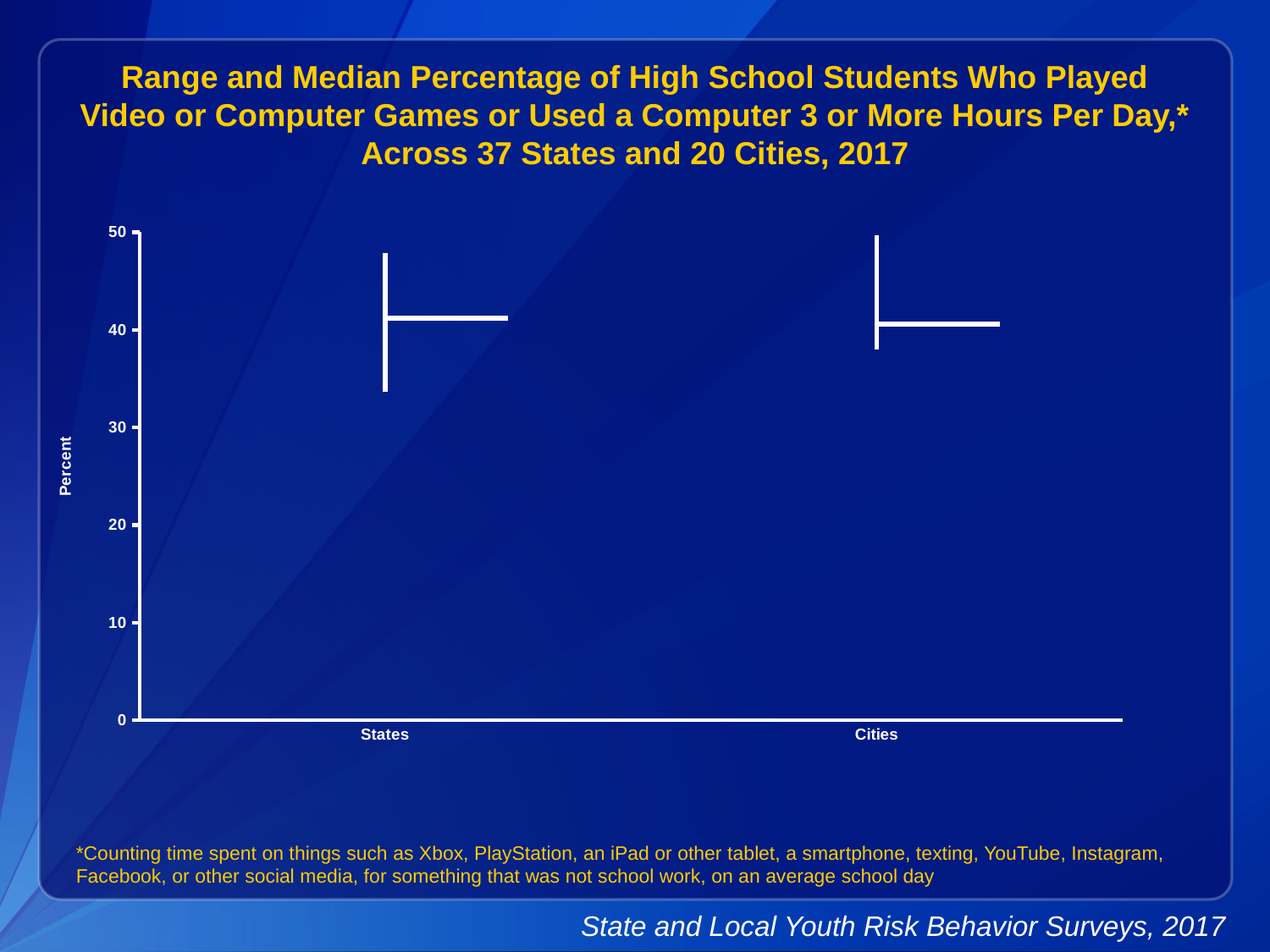
How many categories are shown on the x axis? 2 Is the median value for States greater or less than 40? greater Which category has the higher minimum value in its range, States or Cities? Cities Is the lowest value in the range for Cities greater or less than 30? greater Is the highest value in the range for States greater or less than 50? less What kind of chart is shown on the slide? A range (high-low) chart showing range and median Which category has the higher maximum value in its range, States or Cities? Cities What is the label on the y axis? Percent What are the two categories on the x axis? States and Cities